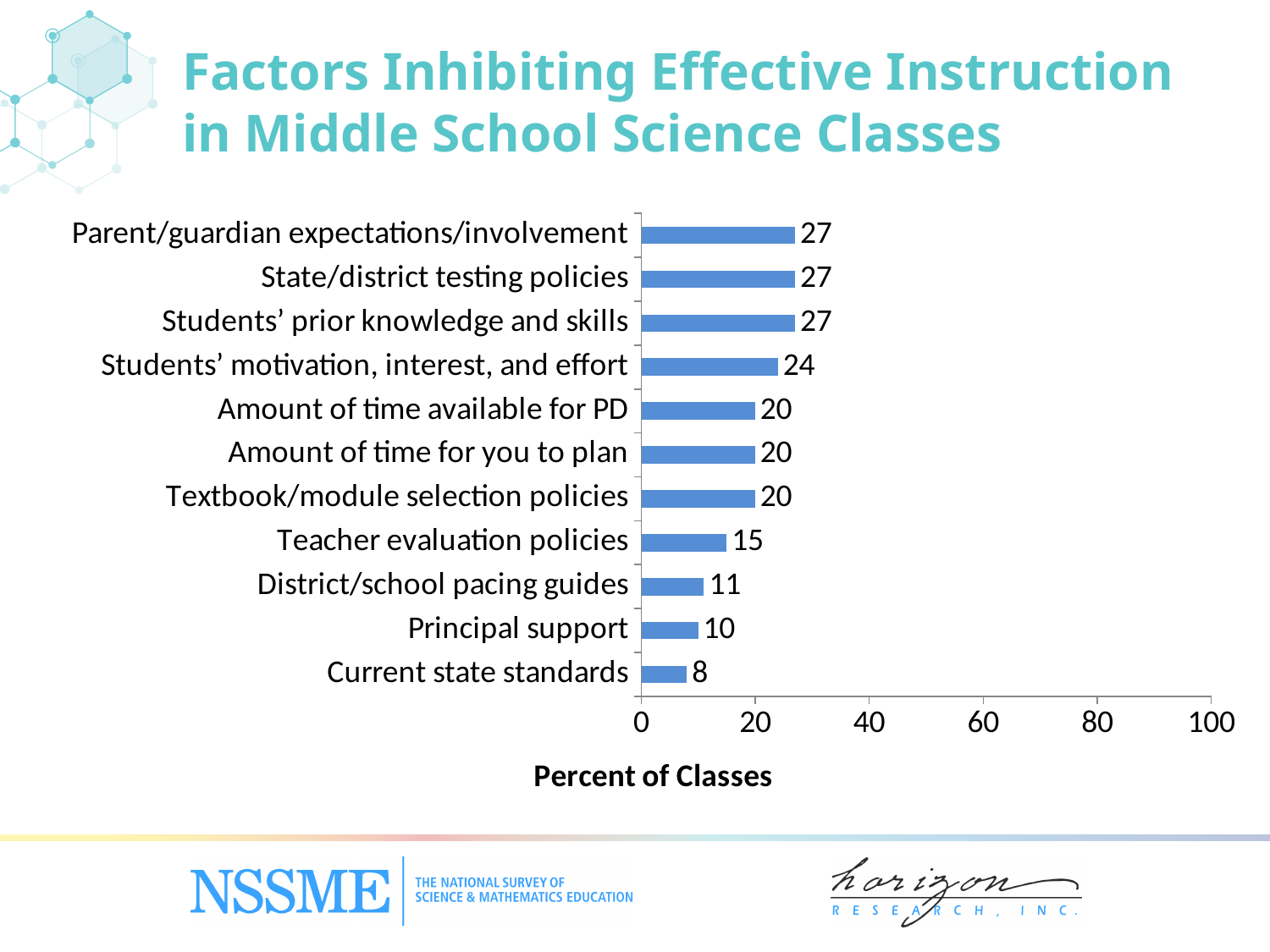
Is the value for Parent/guardian expectations/involvement greater or less than 20? greater Which category has the lowest value? Current state standards What is the value for Teacher evaluation policies? 15 Is the value for Principal support greater or less than 20? less What kind of chart is shown on the slide? bar chart What is the value for Students' motivation, interest, and effort? 24 What is the label of the horizontal axis? Percent of Classes What is the difference between the values for State/district testing policies and Teacher evaluation policies? 12 What is the difference between the values for Students' motivation, interest, and effort and Principal support? 14 What is the value for District/school pacing guides? 11 How many categories are shown in the chart? 11 Which is larger, the value for Amount of time for you to plan or the value for District/school pacing guides? Amount of time for you to plan